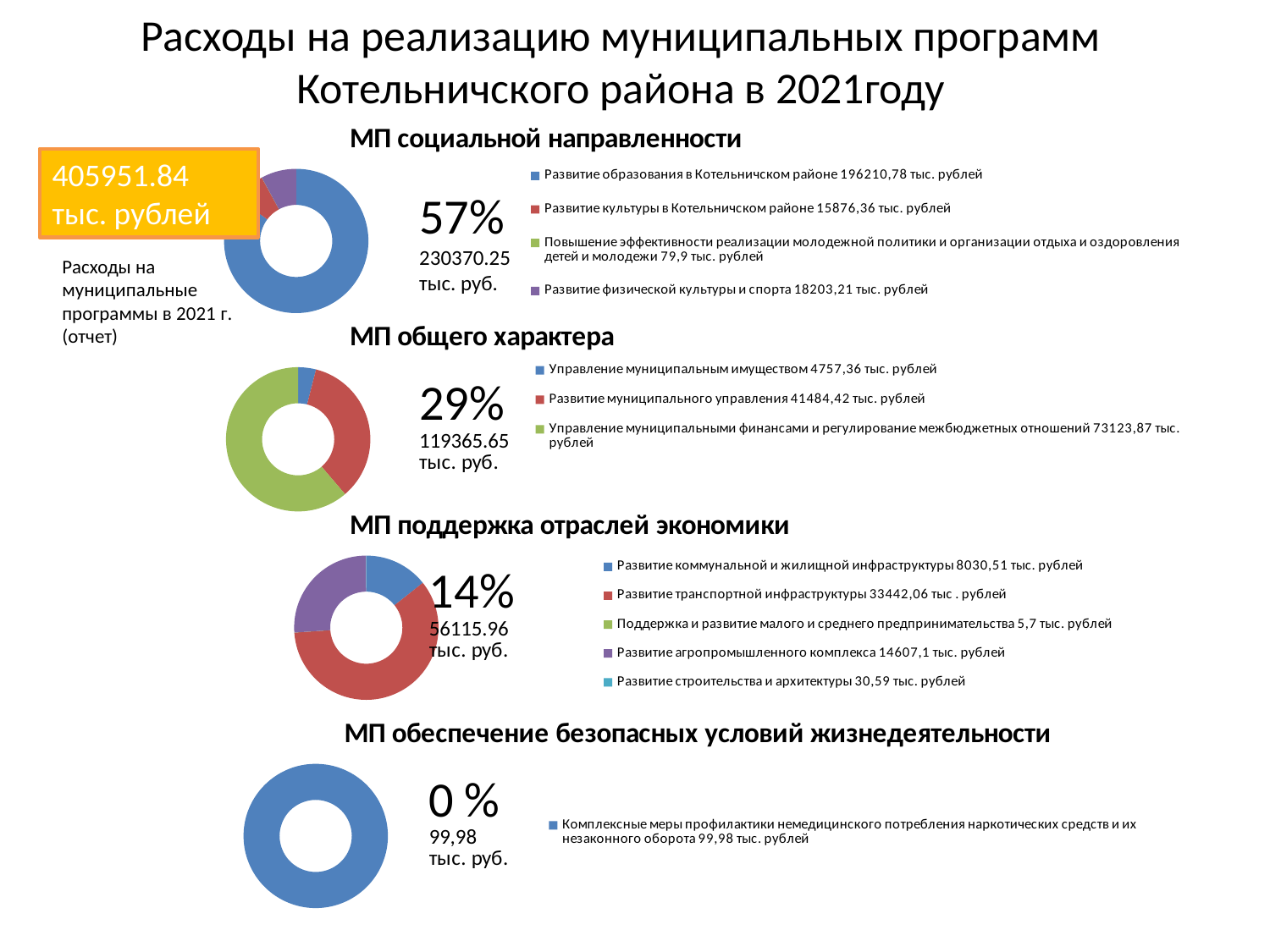
What is the value of the single category in the 'МП обеспечение безопасных условий жизнедеятельности' chart? 99,98 тыс. рублей What kind of chart is used for 'МП социальной направленности'? Donut (pie) chart What total value is shown next to the 'МП общего характера' chart? 119365.65 тыс. руб. In the 'МП поддержка отраслей экономики' chart, what is the value for 'Развитие транспортной инфраструктуры'? 33442,06 тыс. рублей In the 'МП общего характера' chart, what is the difference between 'Развитие муниципального управления' and 'Управление муниципальным имуществом'? 36727,06 тыс. рублей How many categories does the legend of the 'МП поддержка отраслей экономики' chart list? 5 In the 'МП социальной направленности' chart, what is the value for 'Развитие образования в Котельничском районе'? 196210,78 тыс. рублей In the 'МП общего характера' chart, which category has the largest value? Управление муниципальными финансами и регулирование межбюджетных отношений What percentage share is shown next to the 'МП социальной направленности' chart? 57% In the 'МП социальной направленности' chart, which category has the smallest value? Повышение эффективности реализации молодежной политики и организации отдыха и оздоровления детей и молодежи In the 'МП поддержка отраслей экономики' chart, which is larger: 'Развитие агропромышленного комплекса' or 'Развитие коммунальной и жилищной инфраструктуры'? Развитие агропромышленного комплекса How many categories does the legend of the 'МП социальной направленности' chart list? 4